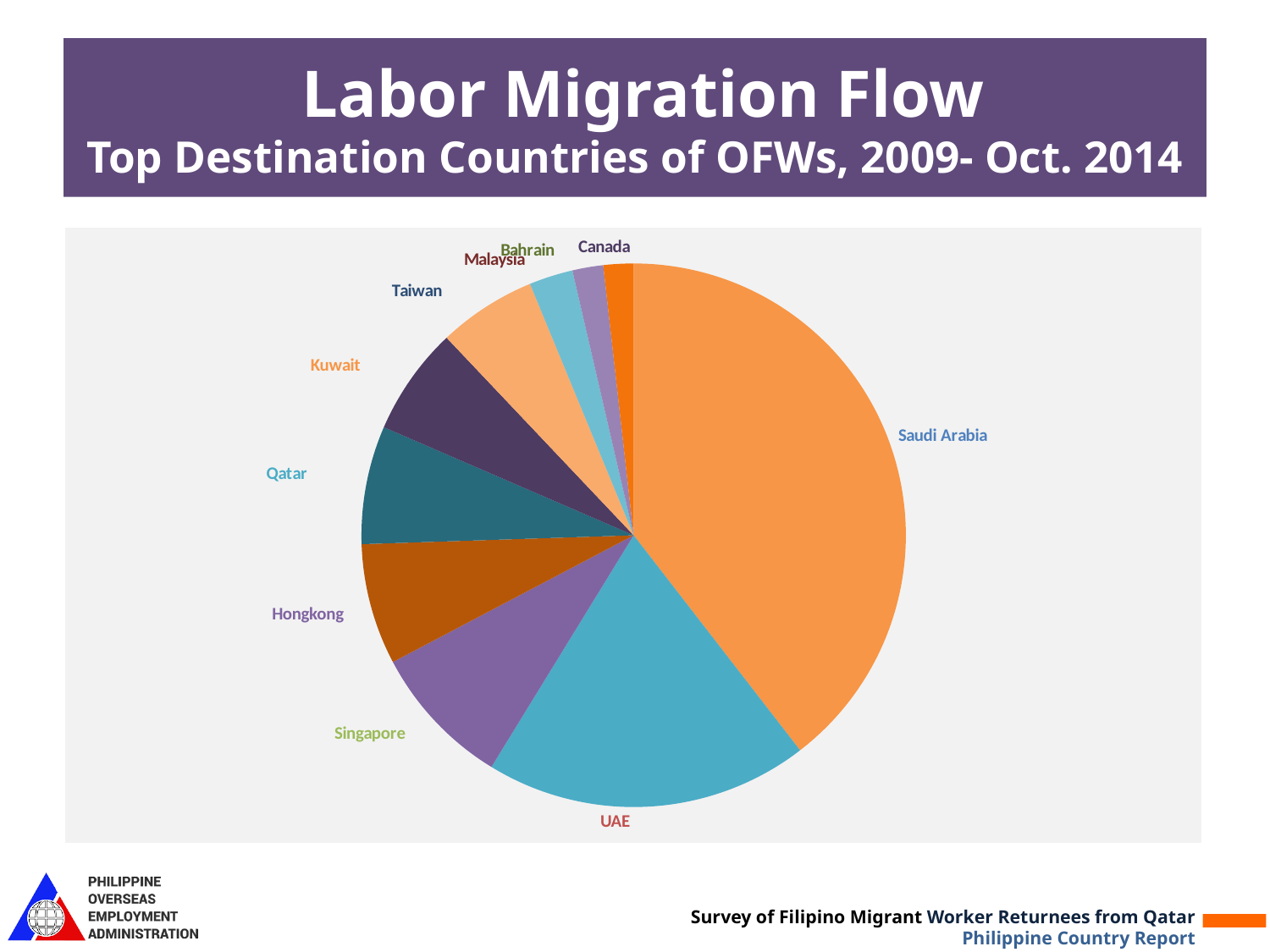
How many destination countries are shown as slices in the pie chart? 10 Which destination country has the second-largest slice of the pie chart? UAE Which slice is larger, Saudi Arabia or UAE? Saudi Arabia What kind of chart is shown on the slide? Pie chart What is the subtitle of the chart shown on the slide? Top Destination Countries of OFWs, 2009- Oct. 2014 Which slice is larger, UAE or Singapore? UAE Which slice is larger, Kuwait or Canada? Kuwait What colour is the Saudi Arabia slice in the pie chart? Orange Which destination country has the largest slice of the pie chart? Saudi Arabia